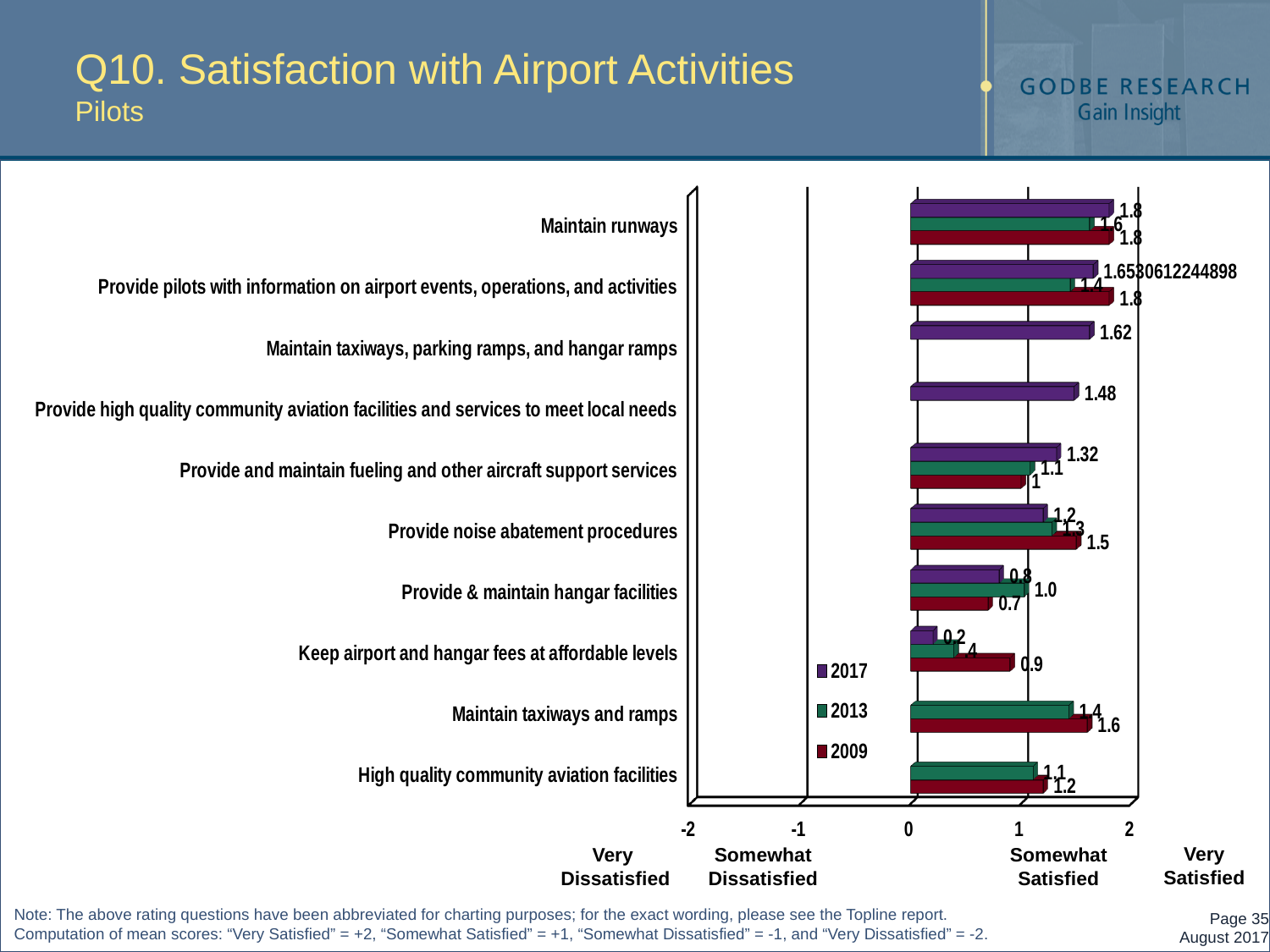
What is the 2017 value for "Maintain taxiways, parking ramps, and hangar ramps"? 1.62 What is the 2013 value for "Provide & maintain hangar facilities"? 1.0 Which activity has the highest 2013 value? Maintain runways What type of chart is shown on the slide? Bar chart For "Provide noise abatement procedures", which year has the larger value, 2009 or 2017? 2009 How many years does the legend list? 3 Is the 2017 value for "Keep airport and hangar fees at affordable levels" greater or less than 1? less What is the 2009 value for "Keep airport and hangar fees at affordable levels"? 0.9 What is the 2017 value for "Provide high quality community aviation facilities and services to meet local needs"? 1.48 How many airport activities are listed on the chart? 10 For "Keep airport and hangar fees at affordable levels", how much higher is the 2009 value than the 2017 value? 0.7 Which activity has the lowest 2017 value? Keep airport and hangar fees at affordable levels